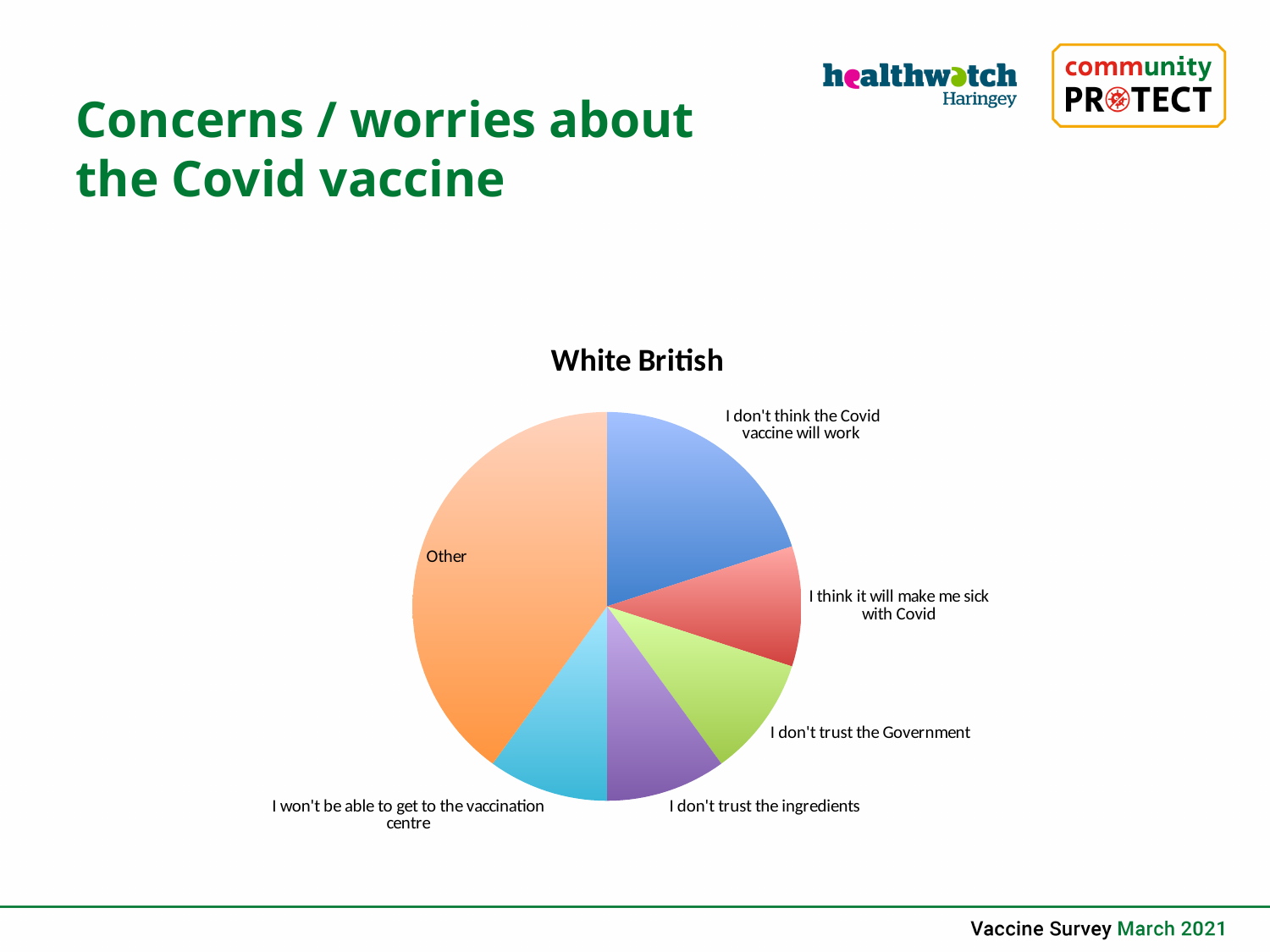
What kind of chart is shown on the slide? Pie chart How many slices does the pie chart have? 6 What is the title of the pie chart? White British Which slice is larger: "I don't think the Covid vaccine will work" or "I don't trust the ingredients"? I don't think the Covid vaccine will work Which category is the second-largest slice of the pie chart? I don't think the Covid vaccine will work Which slice is larger: "Other" or "I don't think the Covid vaccine will work"? Other Which slice is larger: "Other" or "I won't be able to get to the vaccination centre"? Other What colour is the "Other" slice of the pie chart? Orange Which category has the largest slice of the pie chart? Other